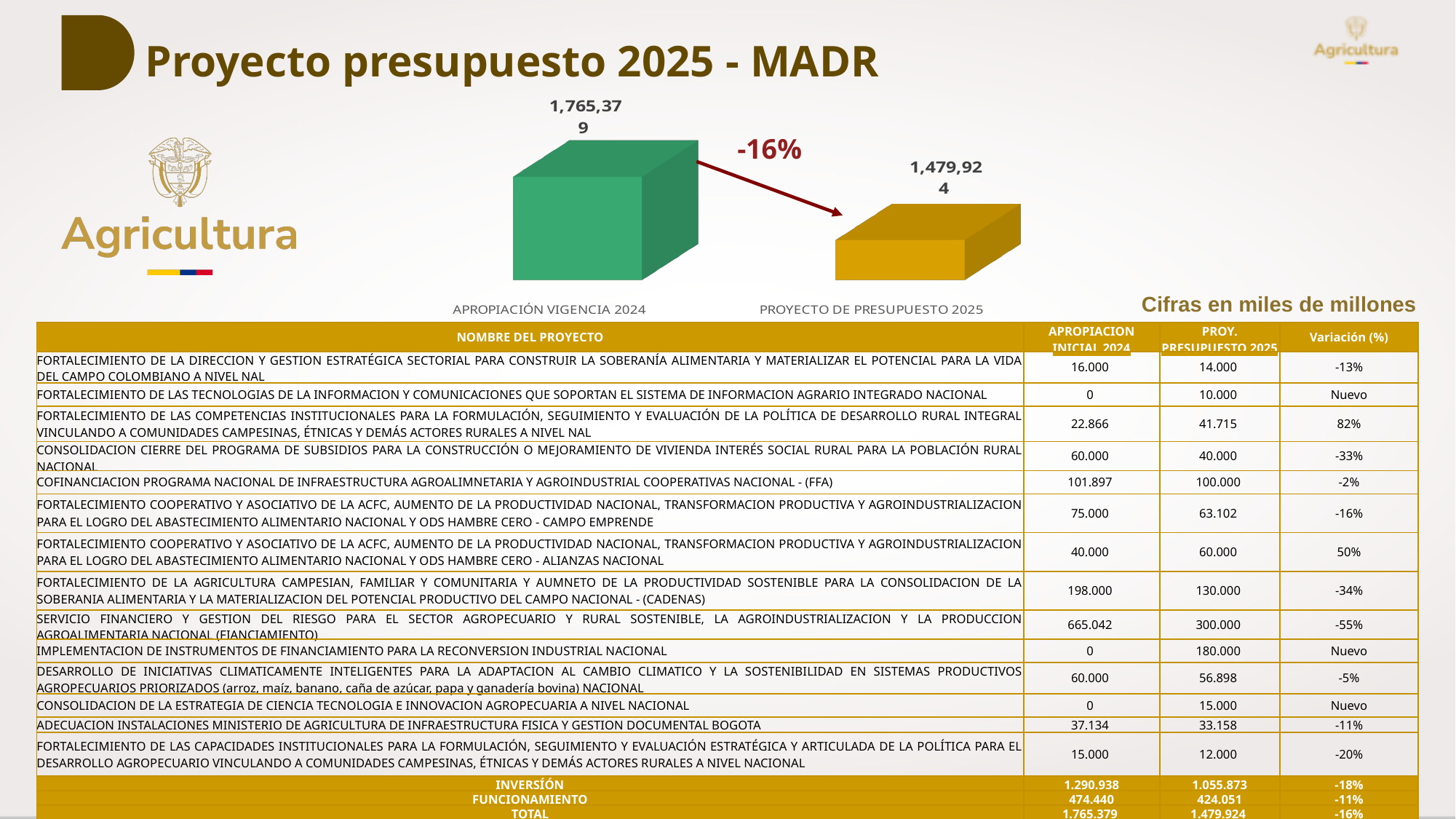
What is the value for APROPIACIÓN VIGENCIA 2024 in the chart? 1,765,379 What colour is the bar for PROYECTO DE PRESUPUESTO 2025 in the chart? Gold/yellow What kind of chart is shown on the slide? Bar chart Which category in the chart has the lowest value? PROYECTO DE PRESUPUESTO 2025 What is the value for PROYECTO DE PRESUPUESTO 2025 in the chart? 1,479,924 What is the difference between the APROPIACIÓN VIGENCIA 2024 value and the PROYECTO DE PRESUPUESTO 2025 value in the chart? 285,455 How many categories are plotted in the chart? 2 Which category in the chart has the highest value? APROPIACIÓN VIGENCIA 2024 What percentage change is annotated on the arrow between the two bars in the chart? -16% Do the values in the chart rise or fall from APROPIACIÓN VIGENCIA 2024 to PROYECTO DE PRESUPUESTO 2025? Fall Which is larger in the chart, APROPIACIÓN VIGENCIA 2024 or PROYECTO DE PRESUPUESTO 2025? APROPIACIÓN VIGENCIA 2024